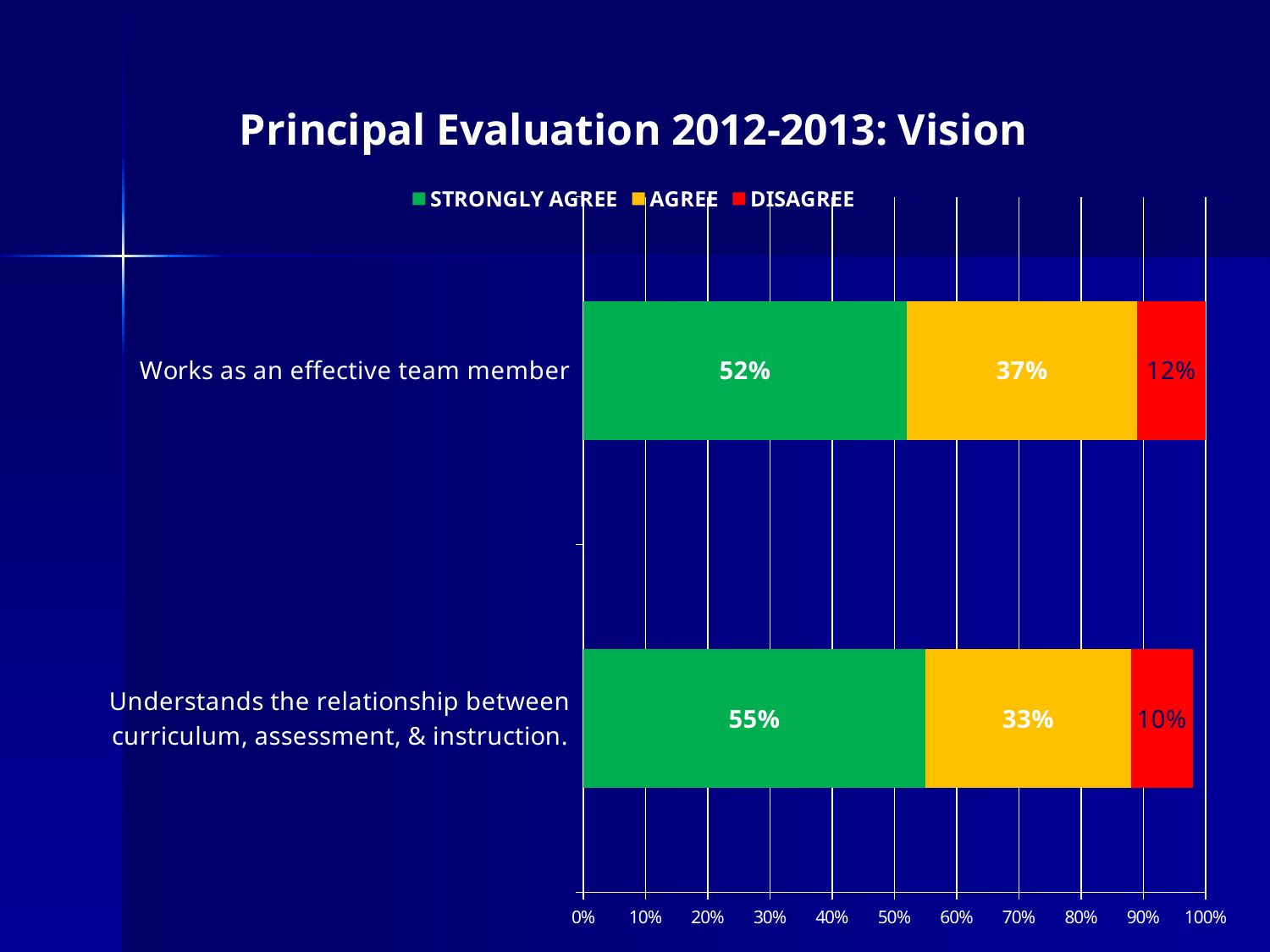
What is the title of the chart? Principal Evaluation 2012-2013: Vision What kind of chart is shown on the slide? Stacked bar chart How many categories are shown on the chart? 2 How many series does the legend list? 3 Which category has the lower Disagree percentage? Understands the relationship between curriculum, assessment, & instruction. Which category has the higher Strongly Agree percentage? Understands the relationship between curriculum, assessment, & instruction. What is the Agree value for "Understands the relationship between curriculum, assessment, & instruction."? 33% What is the difference in percentage points between the Agree values for the two categories? 4 Is the Strongly Agree value for "Works as an effective team member" larger or smaller than the Strongly Agree value for "Understands the relationship between curriculum, assessment, & instruction."? smaller What percentage of respondents strongly agree that the principal works as an effective team member? 52% What is the Disagree value for "Works as an effective team member"? 12% What is the Strongly Agree value for "Understands the relationship between curriculum, assessment, & instruction."? 55%